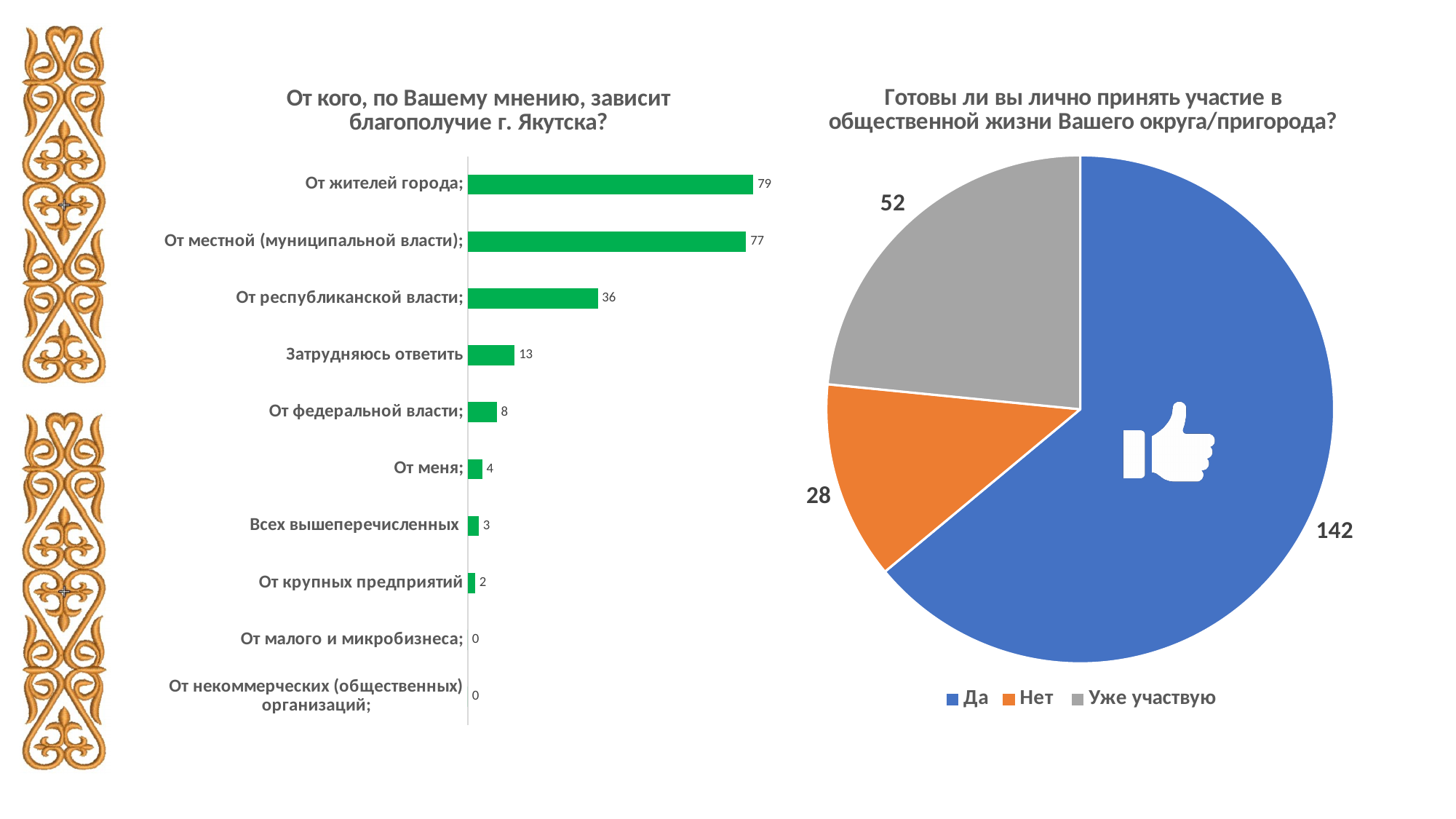
In the right chart 'Готовы ли вы лично принять участие в общественной жизни Вашего округа/пригорода?', what is the difference between 'Уже участвую' and 'Нет'? 24 In the left chart 'От кого, по Вашему мнению, зависит благополучие г. Якутска?', what is the value for 'От жителей города;'? 79 How many series does the legend of the right chart 'Готовы ли вы лично принять участие в общественной жизни Вашего округа/пригорода?' list? 3 How many categories are shown in the left chart 'От кого, по Вашему мнению, зависит благополучие г. Якутска?'? 10 What type of chart is the right chart 'Готовы ли вы лично принять участие в общественной жизни Вашего округа/пригорода?'? Pie chart In the left chart 'От кого, по Вашему мнению, зависит благополучие г. Якутска?', what is the value for 'От республиканской власти;'? 36 In the right chart 'Готовы ли вы лично принять участие в общественной жизни Вашего округа/пригорода?', which category has the lowest value? Нет In the right chart 'Готовы ли вы лично принять участие в общественной жизни Вашего округа/пригорода?', what is the value for 'Да'? 142 What type of chart is the left chart 'От кого, по Вашему мнению, зависит благополучие г. Якутска?'? Bar chart In the left chart 'От кого, по Вашему мнению, зависит благополучие г. Якутска?', which category has the highest value? От жителей города; In the left chart 'От кого, по Вашему мнению, зависит благополучие г. Якутска?', what is the difference between 'От жителей города;' and 'От местной (муниципальной власти);'? 2 In the left chart 'От кого, по Вашему мнению, зависит благополучие г. Якутска?', which is larger: 'Затрудняюсь ответить' or 'От федеральной власти;'? Затрудняюсь ответить